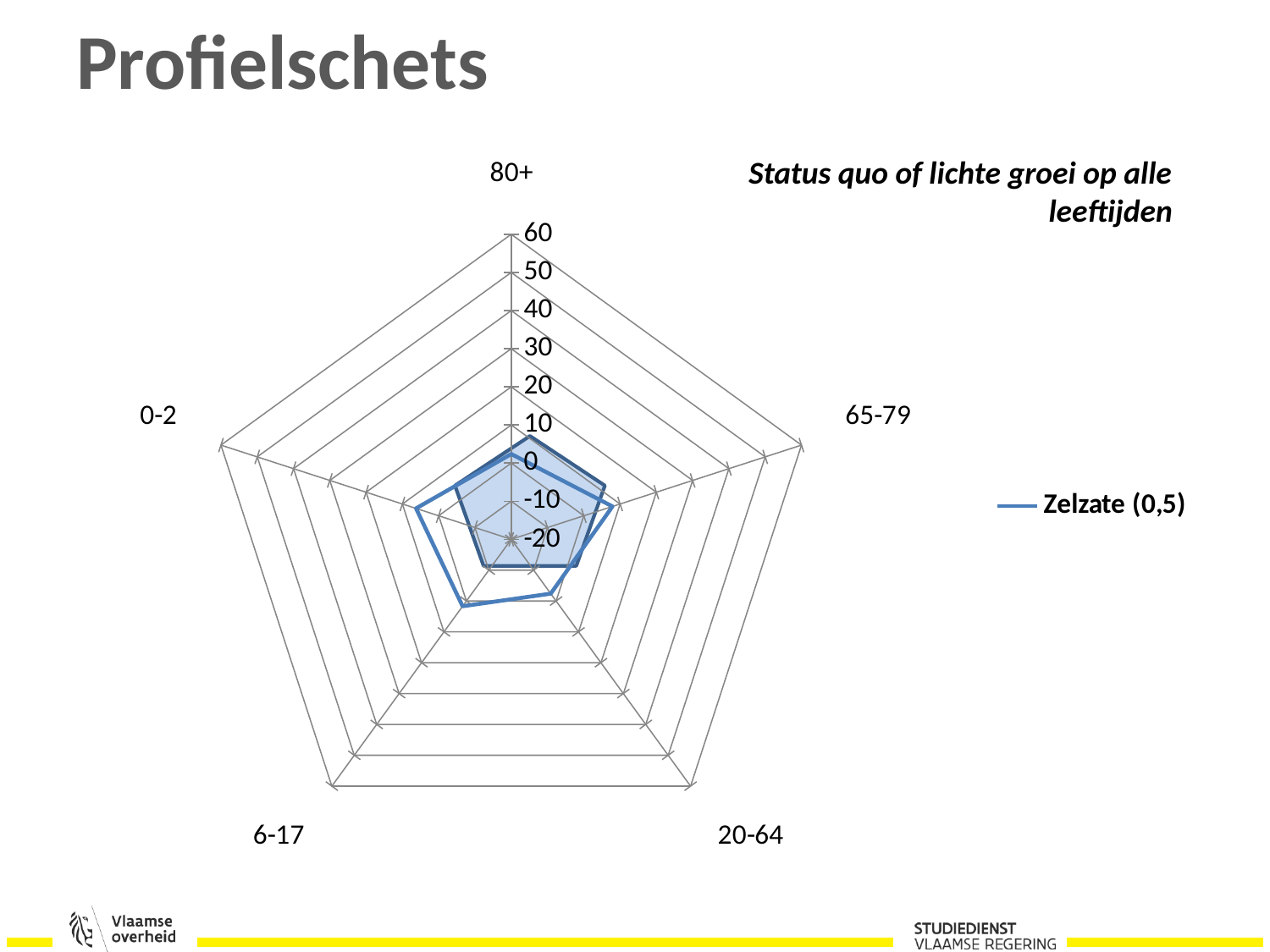
Is the value for 20-64 greater or less than -10? greater Is the value for 6-17 greater or less than -10? greater Is the value for 6-17 greater or less than 10? less How many age categories are plotted on the radar chart? 5 What is the highest value shown on the radar chart's axis scale? 60 What is the name of the series shown in the legend of the radar chart? Zelzate (0,5) What kind of chart is shown on the slide? radar chart How many series does the legend of the radar chart list? 1